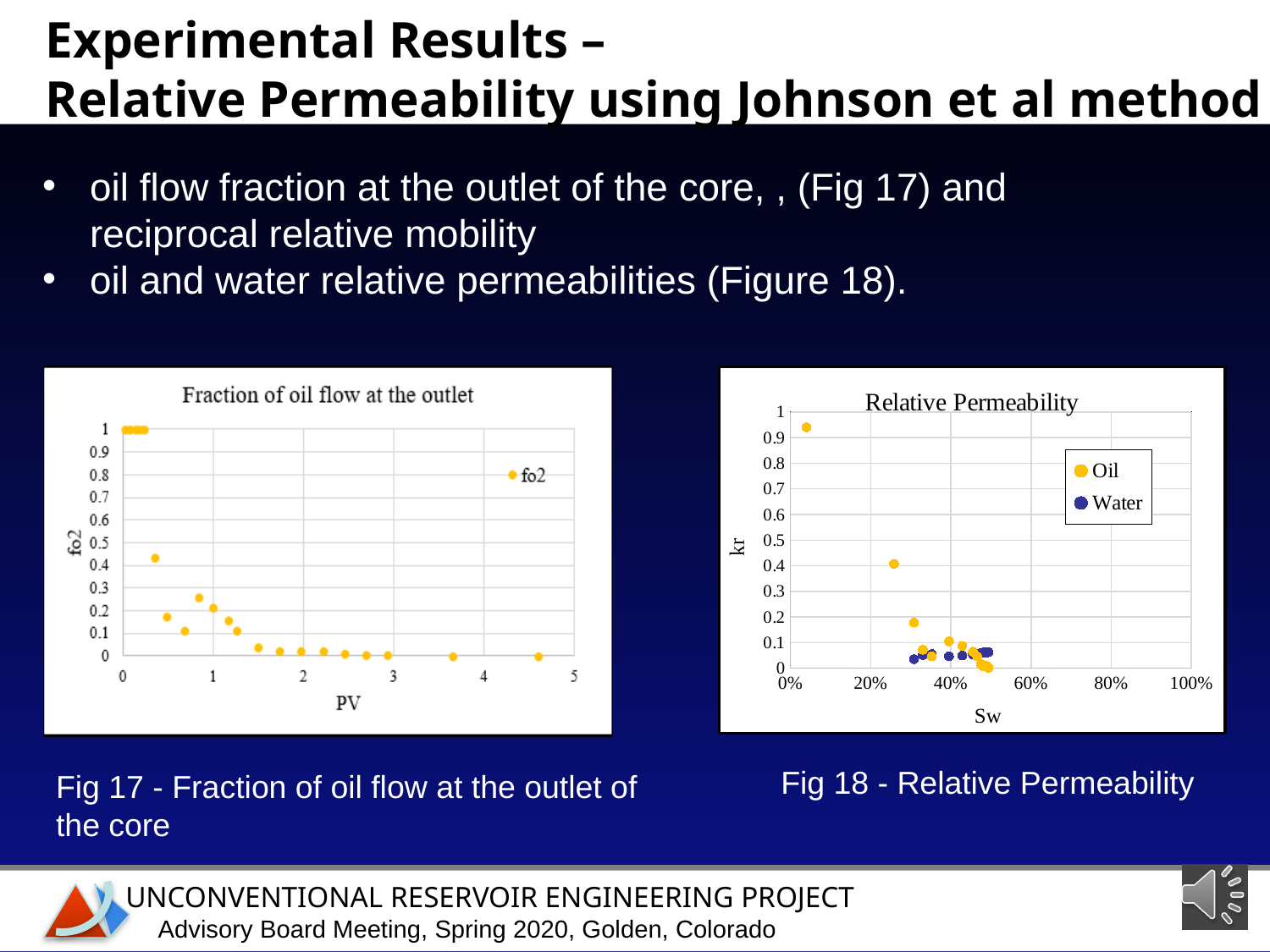
How many series does the legend of the 'Fraction of oil flow at the outlet' chart list? 1 What kind of chart is the 'Fraction of oil flow at the outlet' chart on the left? scatter chart In the 'Relative Permeability' chart, do the Oil values rise or fall as Sw increases? fall What is the x-axis label of the 'Fraction of oil flow at the outlet' chart? PV In the 'Fraction of oil flow at the outlet' chart, is the fo2 value at PV = 4 greater or less than 0.1? less What is the x-axis label of the 'Relative Permeability' chart? Sw In the 'Fraction of oil flow at the outlet' chart, do the fo2 values rise or fall as PV increases? fall What kind of chart is the 'Relative Permeability' chart on the right? scatter chart In the 'Fraction of oil flow at the outlet' chart, is the fo2 value at PV = 1 greater or less than 0.5? less In the 'Relative Permeability' chart, is the Oil kr value at the lowest Sw (near 5%) greater or less than 0.9? greater How many series does the legend of the 'Relative Permeability' chart list? 2